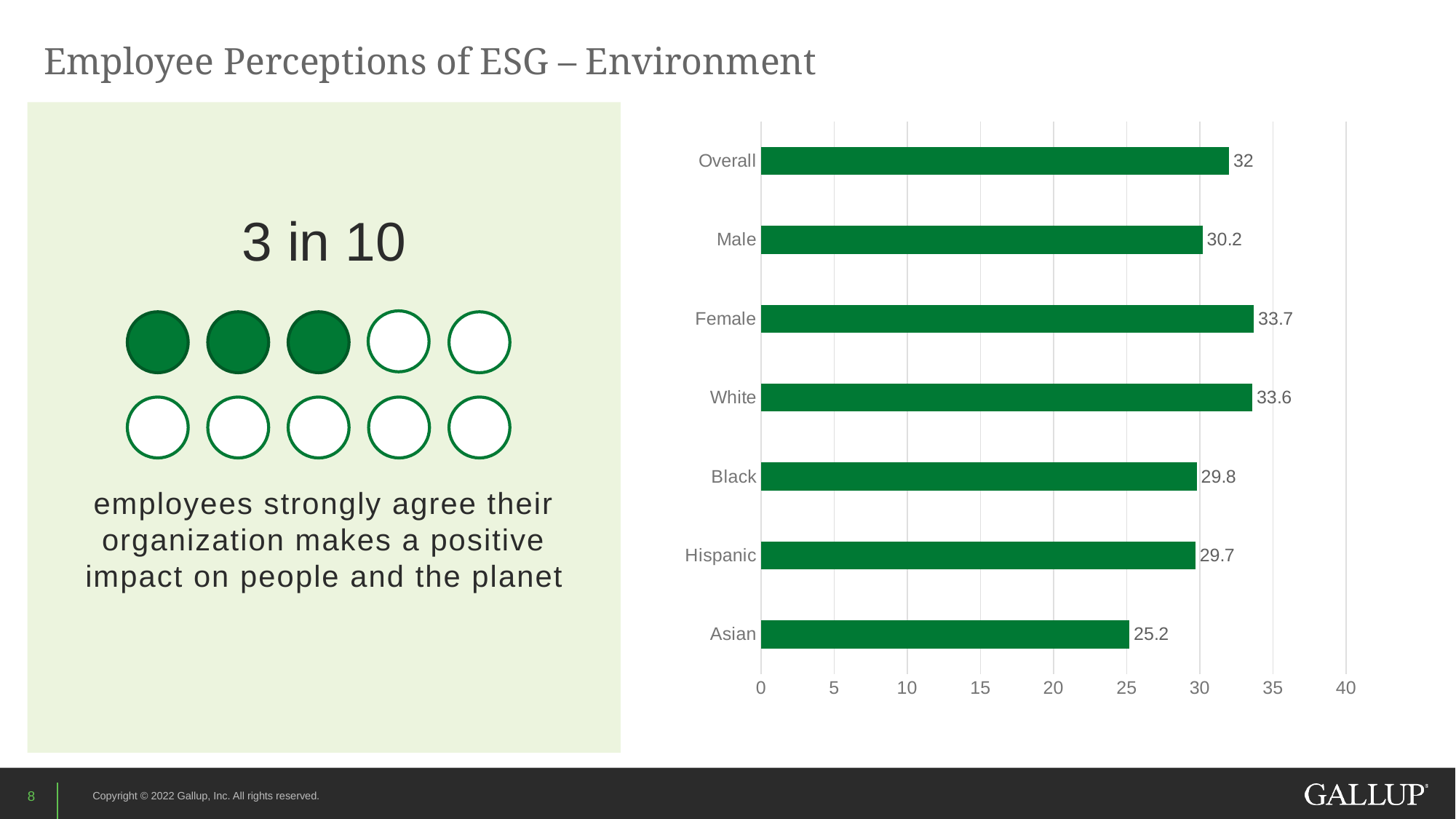
Which category has the lowest value? Asian What kind of chart is shown on the slide? bar chart Which is larger, the value for Male or the value for Black? Male How many categories are shown in the chart? 7 What is the value for Hispanic? 29.7 What is the value for Female? 33.7 What is the value for Overall? 32 What is the value for Asian? 25.2 What is the difference between the values for Overall and Asian? 6.8 Which category has the highest value? Female What is the difference between the values for Female and Male? 3.5 Is the value for Asian greater or less than 30? less